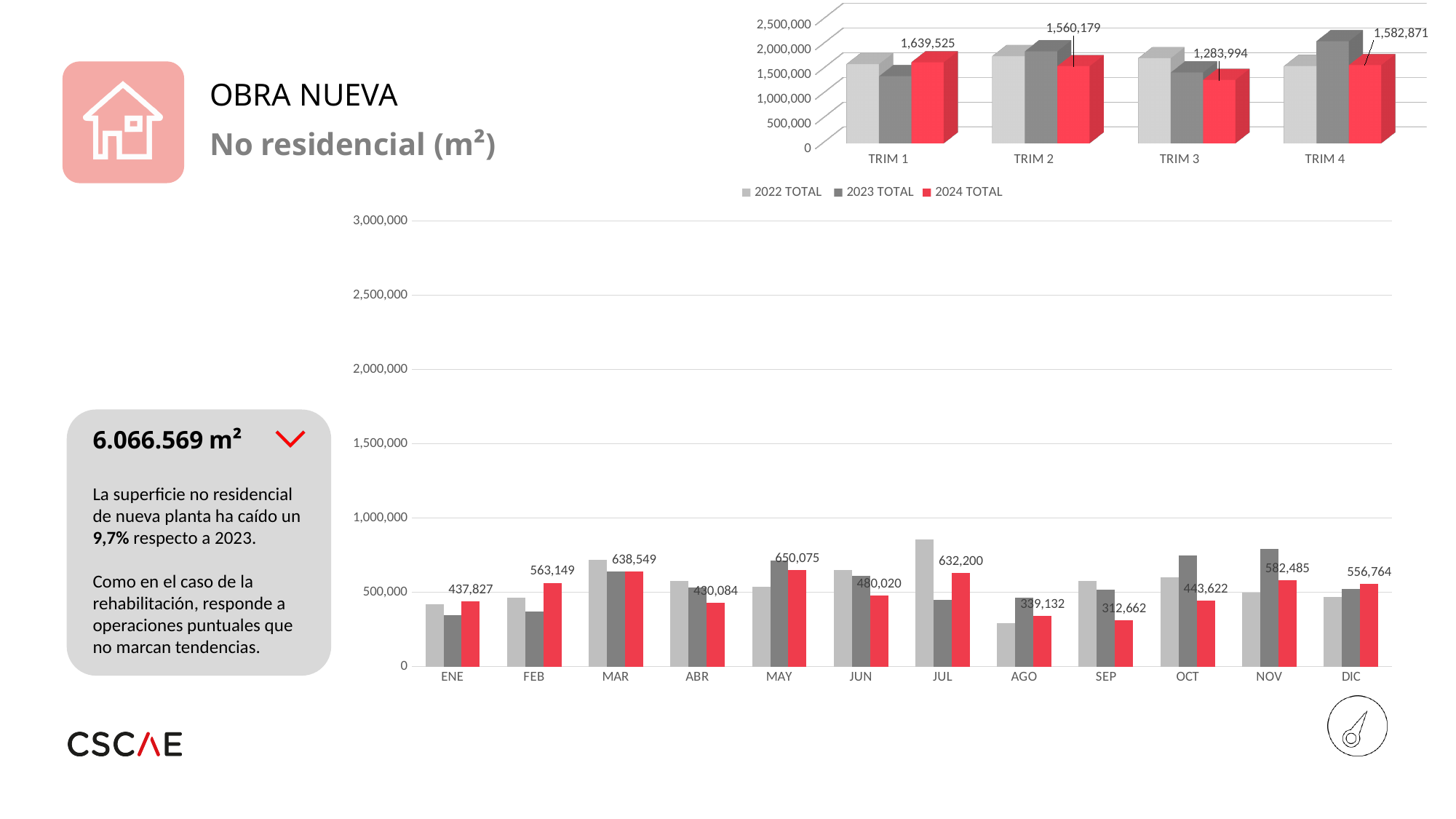
In the quarterly chart at the top right, what is the 2024 TOTAL value for TRIM 3? 1,283,994 In the monthly chart at the bottom, which month has the highest 2024 value? MAY In the monthly chart at the bottom, which month has the lowest 2024 value? SEP In the monthly chart at the bottom, what is the 2024 value for FEB? 563,149 In the quarterly chart at the top right, what is the 2024 TOTAL value for TRIM 1? 1,639,525 In the quarterly chart at the top right, what is the difference between the 2024 TOTAL values for TRIM 1 and TRIM 2? 79,346 In the monthly chart at the bottom, is the 2022 value for JUL greater or less than 500,000? greater In the quarterly chart at the top right, which quarter has the lowest 2024 TOTAL value? TRIM 3 In the monthly chart at the bottom, how many months are shown on the x axis? 12 In the monthly chart at the bottom, what is the 2024 value for SEP? 312,662 In the quarterly chart at the top right, how many series does the legend list? 3 In the monthly chart at the bottom, which is larger: the 2024 value for JUL or the 2024 value for NOV? JUL